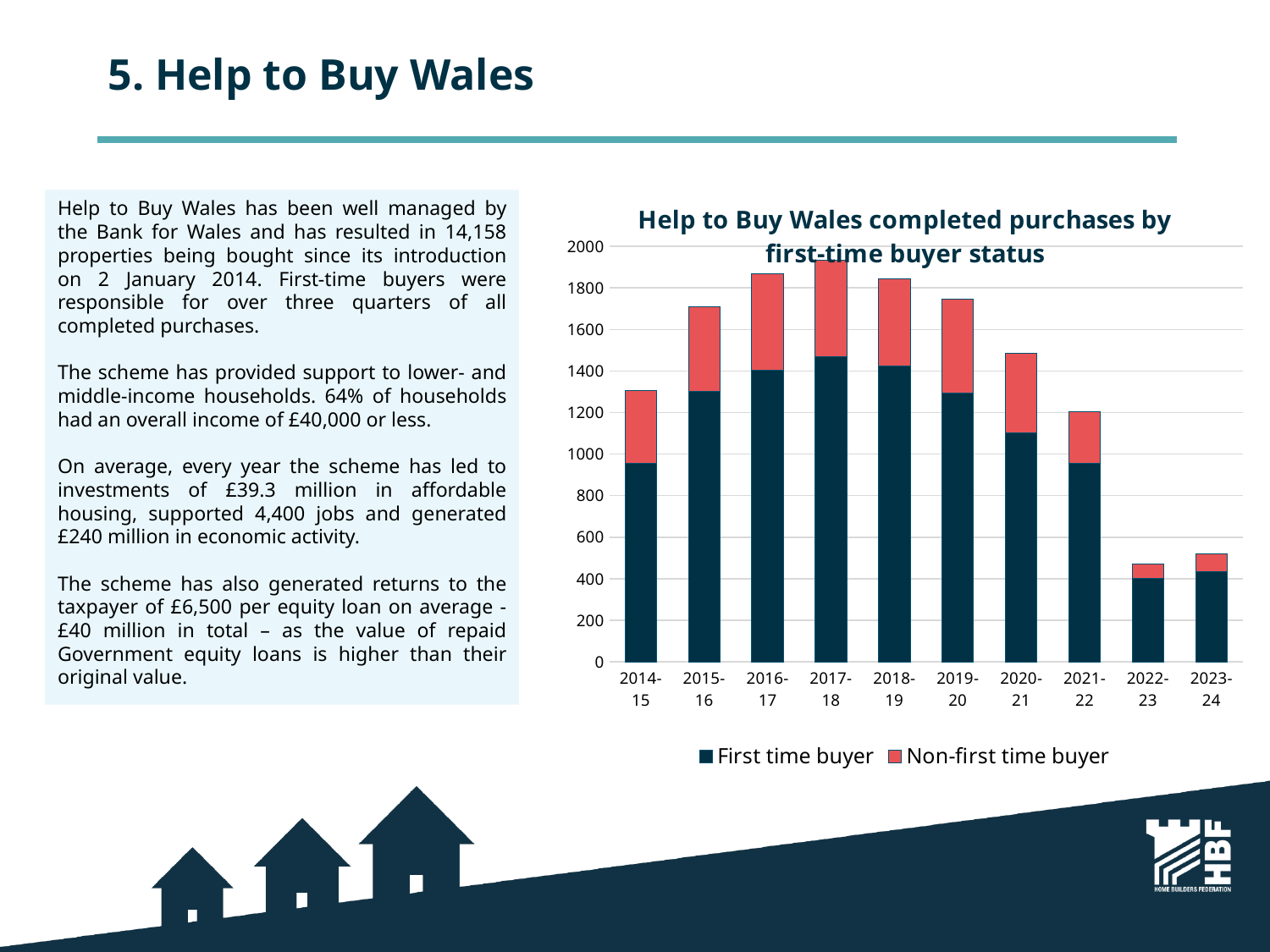
Is the number of first time buyer purchases in 2017-18 greater or less than 1400? greater How many series does the chart's legend list? 2 Is the total number of completed purchases in 2022-23 greater or less than 600? less Do total completed purchases rise or fall from 2017-18 to 2022-23? fall Which year has the highest total of completed purchases? 2017-18 Which year has the larger total of completed purchases, 2015-16 or 2020-21? 2015-16 Is the total number of completed purchases in 2021-22 greater or less than 1000? greater What kind of chart is shown on the slide? Stacked bar chart Which year has the lowest total of completed purchases? 2022-23 How many financial years are shown on the x axis of the chart? 10 Which series is shown in red in the chart? Non-first time buyer